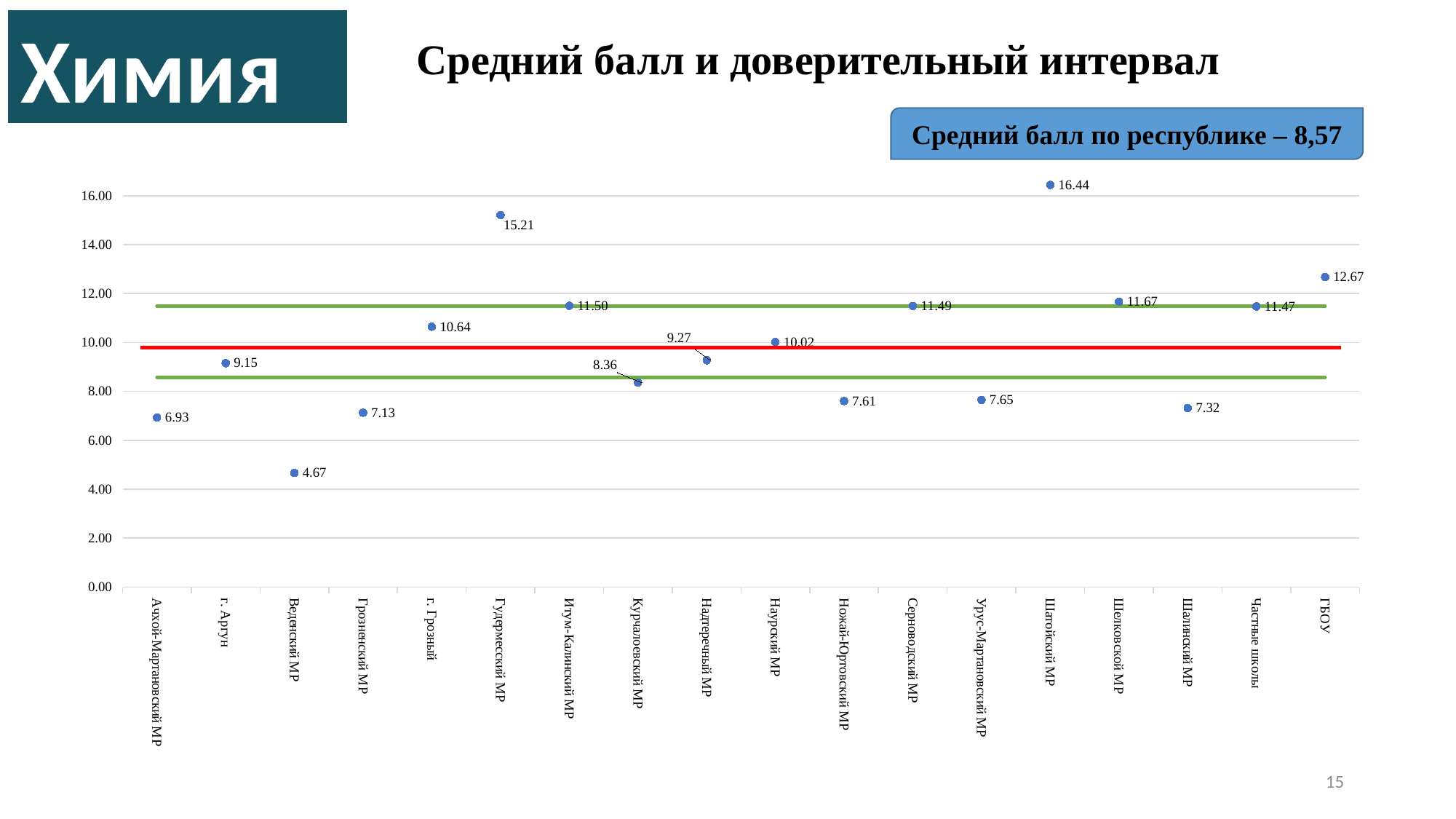
Which category has the lowest value? Веденский МР Is the value for Шелковской МР greater or less than 10.00? greater Which category has the highest value? Шатойский МР What is the value for Гудермесский МР? 15.21 Which is larger, the value for г. Грозный or the value for г. Аргун? г. Грозный What is the difference between the values for Шатойский МР and Гудермесский МР? 1.23 What kind of chart is shown on the slide? Scatter chart What is the average score for the republic stated on the slide? 8,57 What is the value for ГБОУ? 12.67 What is the value for Веденский МР? 4.67 How many categories are plotted on the x axis? 18 What is the value for Шатойский МР? 16.44